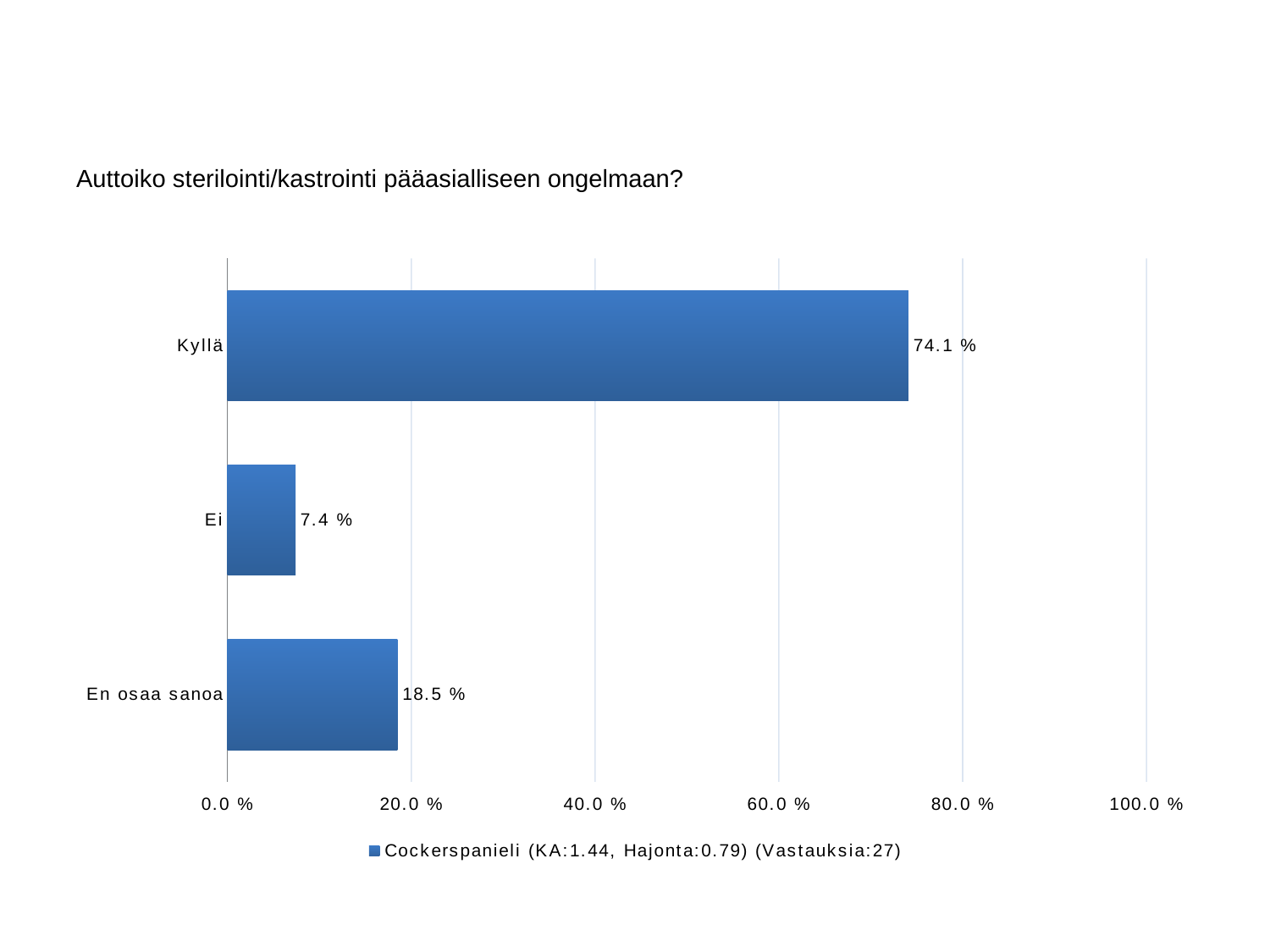
Is the value for Kyllä greater or less than 60.0 %? greater What is the difference between the values for Kyllä and En osaa sanoa? 55.6 % Which category has the highest value? Kyllä How many categories are shown in the chart? 3 What is the value for En osaa sanoa? 18.5 % What is the difference between the values for En osaa sanoa and Ei? 11.1 % What kind of chart is shown on the slide? bar chart What is the title of the chart? Auttoiko sterilointi/kastrointi pääasialliseen ongelmaan? What is the value for Kyllä? 74.1 % Which is larger, the value for Ei or the value for En osaa sanoa? En osaa sanoa What is the value for Ei? 7.4 % Which category has the lowest value? Ei